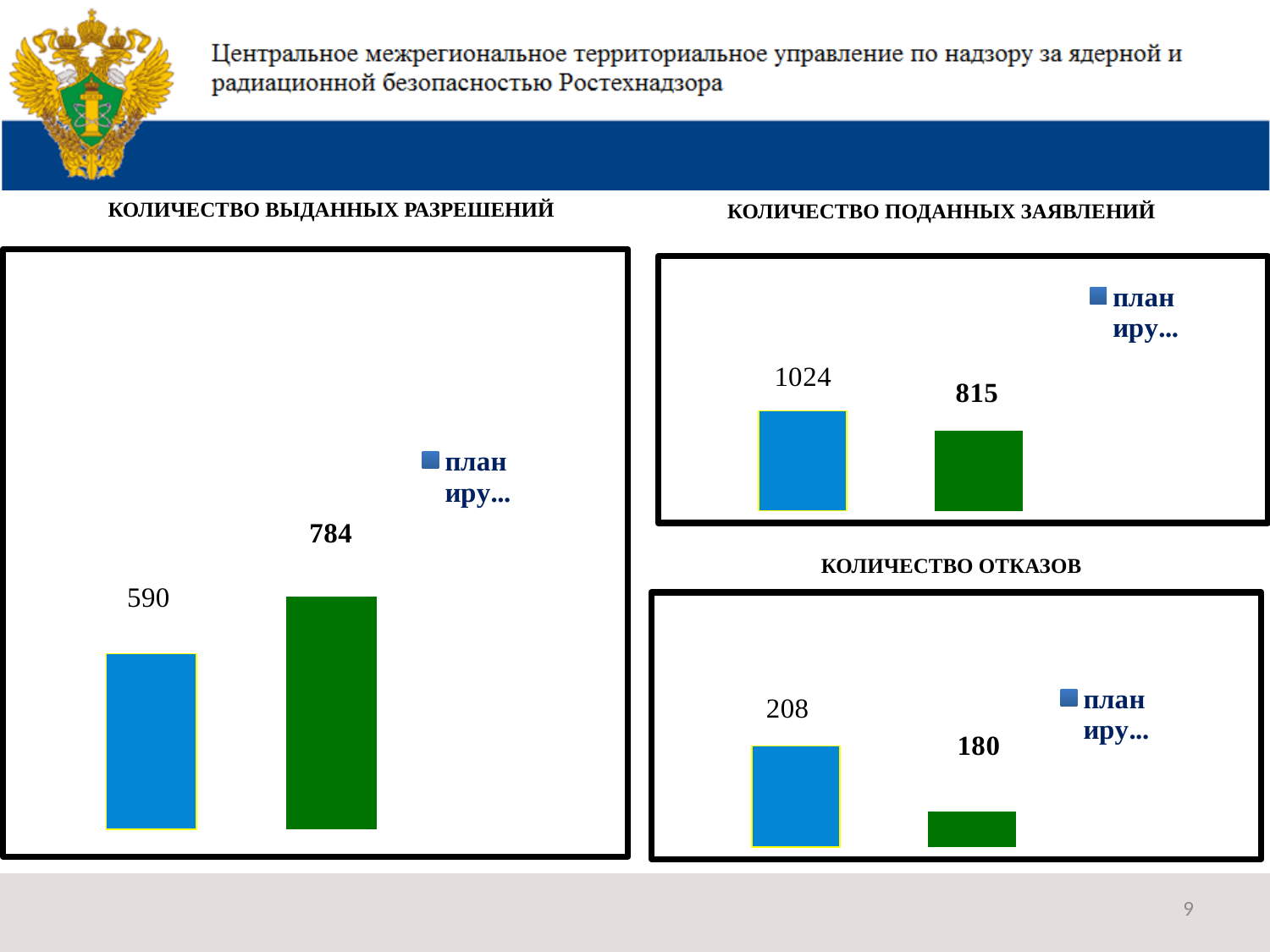
In the chart titled КОЛИЧЕСТВО ПОДАННЫХ ЗАЯВЛЕНИЙ, what is the value of the blue (left) bar? 1024 In the chart titled КОЛИЧЕСТВО ВЫДАННЫХ РАЗРЕШЕНИЙ, what is the difference between the green bar and the blue bar? 194 In the chart titled КОЛИЧЕСТВО ПОДАННЫХ ЗАЯВЛЕНИЙ, what is the value of the green (right) bar? 815 In the chart titled КОЛИЧЕСТВО ВЫДАННЫХ РАЗРЕШЕНИЙ, what is the value of the blue (left) bar? 590 How many bars are plotted in the chart titled КОЛИЧЕСТВО ОТКАЗОВ? 2 In the chart titled КОЛИЧЕСТВО ОТКАЗОВ, what is the value of the green (right) bar? 180 In the chart titled КОЛИЧЕСТВО ПОДАННЫХ ЗАЯВЛЕНИЙ, what is the difference between the blue bar and the green bar? 209 In the chart titled КОЛИЧЕСТВО ОТКАЗОВ, which bar is higher, the blue one or the green one? the blue one In the chart titled КОЛИЧЕСТВО ВЫДАННЫХ РАЗРЕШЕНИЙ, what is the value of the green (right) bar? 784 In the chart titled КОЛИЧЕСТВО ОТКАЗОВ, what is the value of the blue (left) bar? 208 What type of chart is the chart titled КОЛИЧЕСТВО ПОДАННЫХ ЗАЯВЛЕНИЙ? bar chart In the chart titled КОЛИЧЕСТВО ВЫДАННЫХ РАЗРЕШЕНИЙ, which bar has the highest value, the blue one or the green one? the green one